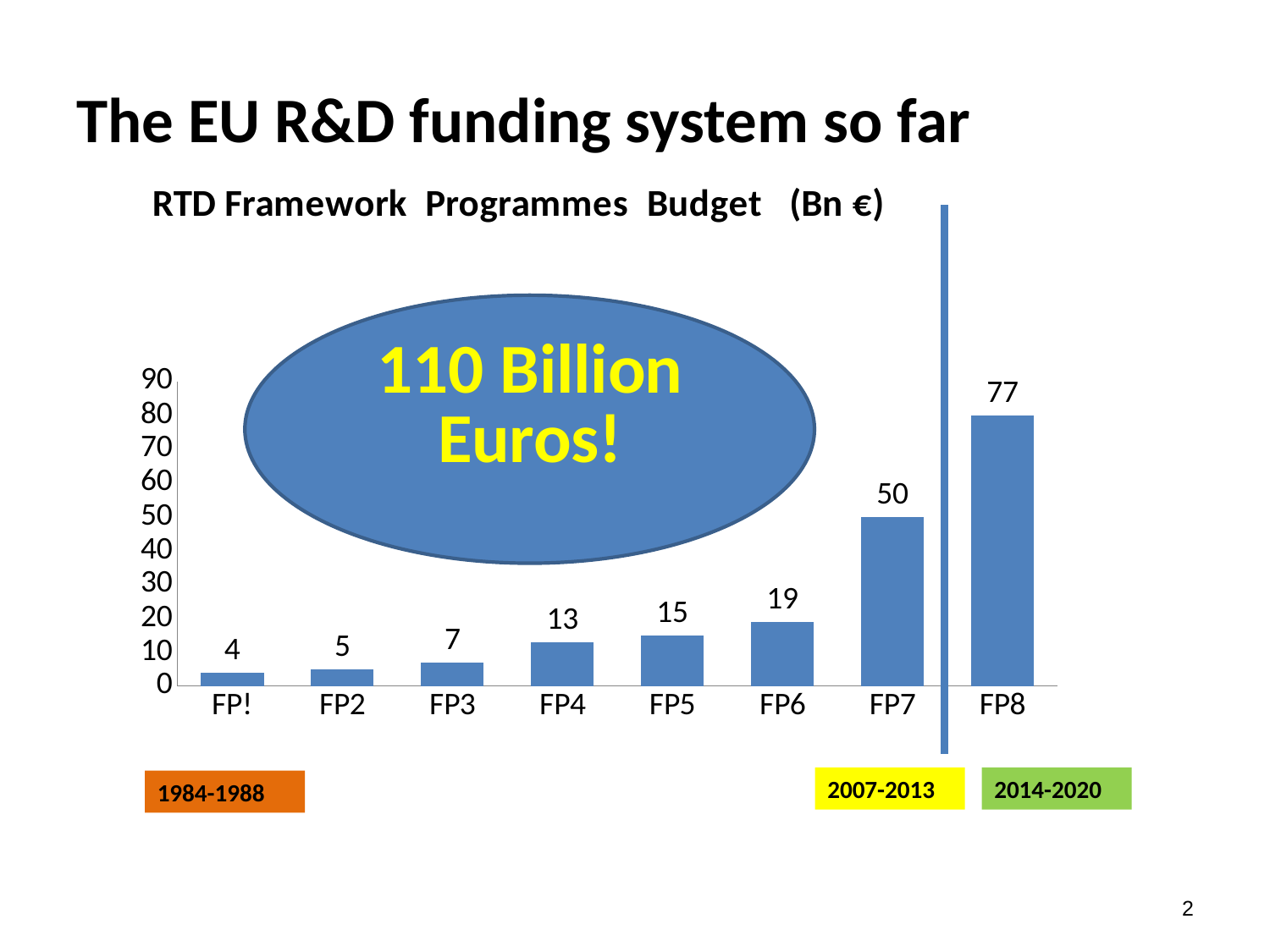
What is the title of the chart? RTD Framework Programmes Budget (Bn €) What type of chart is shown on the slide? Bar chart Which has a larger budget, FP6 or FP4? FP6 What is the difference between the budgets of FP8 and FP7? 27 Do the budget values rise or fall from FP! to FP8? Rise What is the budget value shown for FP7? 50 What is the budget value shown for FP4? 13 Which framework programme has the highest budget? FP8 Which framework programme has the lowest budget? FP! How many framework programmes are shown on the chart? 8 What is the budget value shown for FP2? 5 What is the difference between the budgets of FP6 and FP5? 4